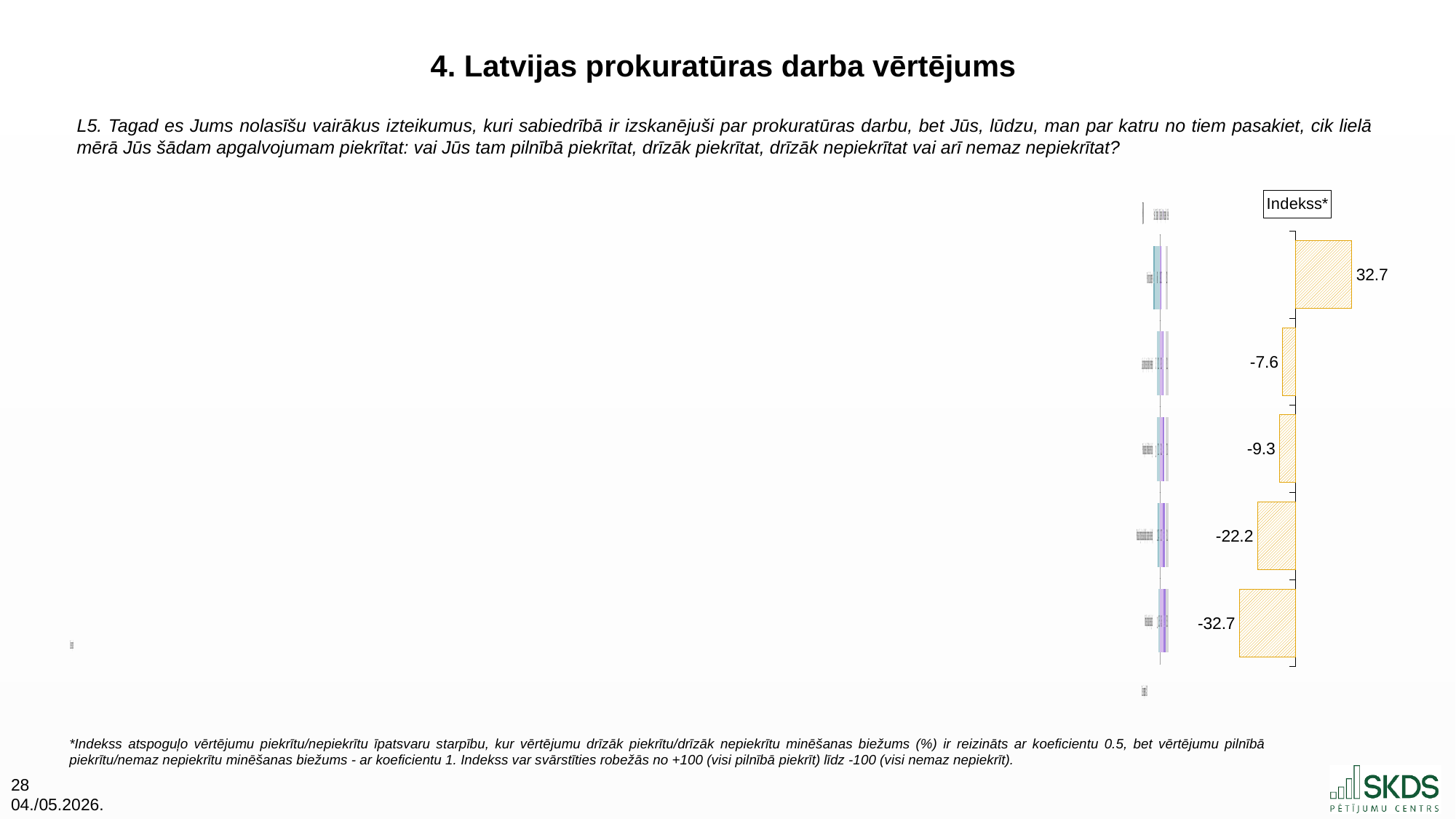
In the Indekss* chart, what is the difference between the top bar (32.7) and the bottom bar (-32.7)? 65.4 In the Indekss* chart, which is larger: the third bar from the top (-9.3) or the fourth bar from the top (-22.2)? the third bar (-9.3) In the Indekss* chart, what is the value of the bottom bar? -32.7 In the Indekss* chart, what is the value of the second bar from the top? -7.6 In the Indekss* chart, how many bars have a negative value? 4 In the Indekss* chart, what is the highest value shown? 32.7 In the Indekss* chart, what is the value of the top bar? 32.7 In the Indekss* chart, what is the difference between the second bar (-7.6) and the third bar (-9.3)? 1.7 In the Indekss* chart, what is the lowest value shown? -32.7 In the Indekss* chart, what is the value of the fourth bar from the top? -22.2 In the Indekss* chart, how many bars are plotted? 5 What kind of chart is the Indekss* chart? bar chart